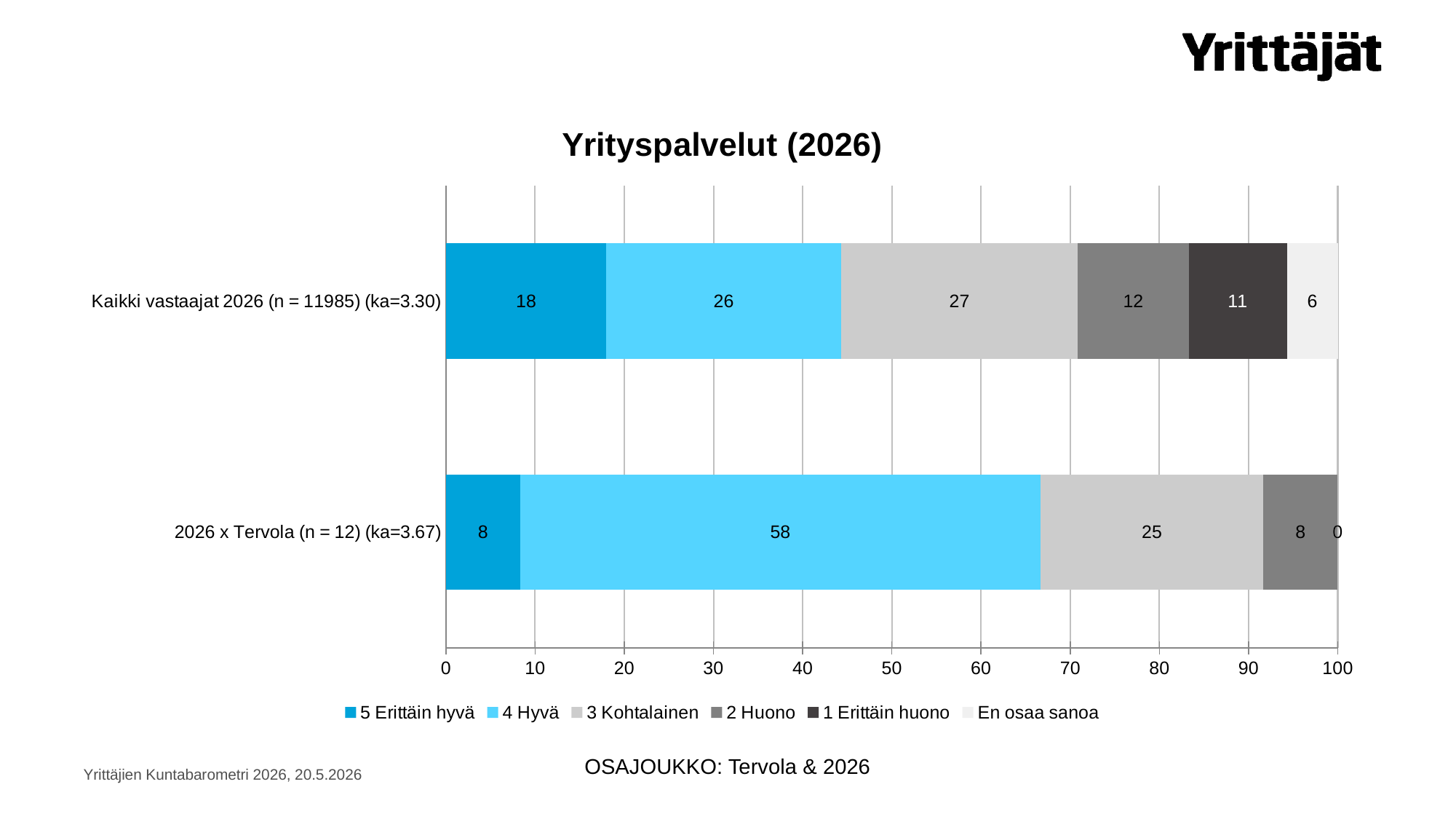
Which segment is the largest in the "2026 x Tervola (n = 12) (ka=3.67)" bar? 4 Hyvä Which segment is the smallest in the "Kaikki vastaajat 2026 (n = 11985) (ka=3.30)" bar? En osaa sanoa What is the title of the chart? Yrityspalvelut (2026) What is the value of "5 Erittäin hyvä" for "2026 x Tervola (n = 12) (ka=3.67)"? 8 Which category has the larger "5 Erittäin hyvä" value, "Kaikki vastaajat 2026 (n = 11985) (ka=3.30)" or "2026 x Tervola (n = 12) (ka=3.67)"? Kaikki vastaajat 2026 (n = 11985) (ka=3.30) What is the value of "4 Hyvä" for "2026 x Tervola (n = 12) (ka=3.67)"? 58 How many categories (bars) are plotted in the chart? 2 What is the difference between the "4 Hyvä" values for "2026 x Tervola (n = 12) (ka=3.67)" and "Kaikki vastaajat 2026 (n = 11985) (ka=3.30)"? 32 What kind of chart is shown on the slide? Stacked horizontal bar chart What is the value of "1 Erittäin huono" for "Kaikki vastaajat 2026 (n = 11985) (ka=3.30)"? 11 What is the value of "3 Kohtalainen" for "Kaikki vastaajat 2026 (n = 11985) (ka=3.30)"? 27 How many series does the legend list? 6